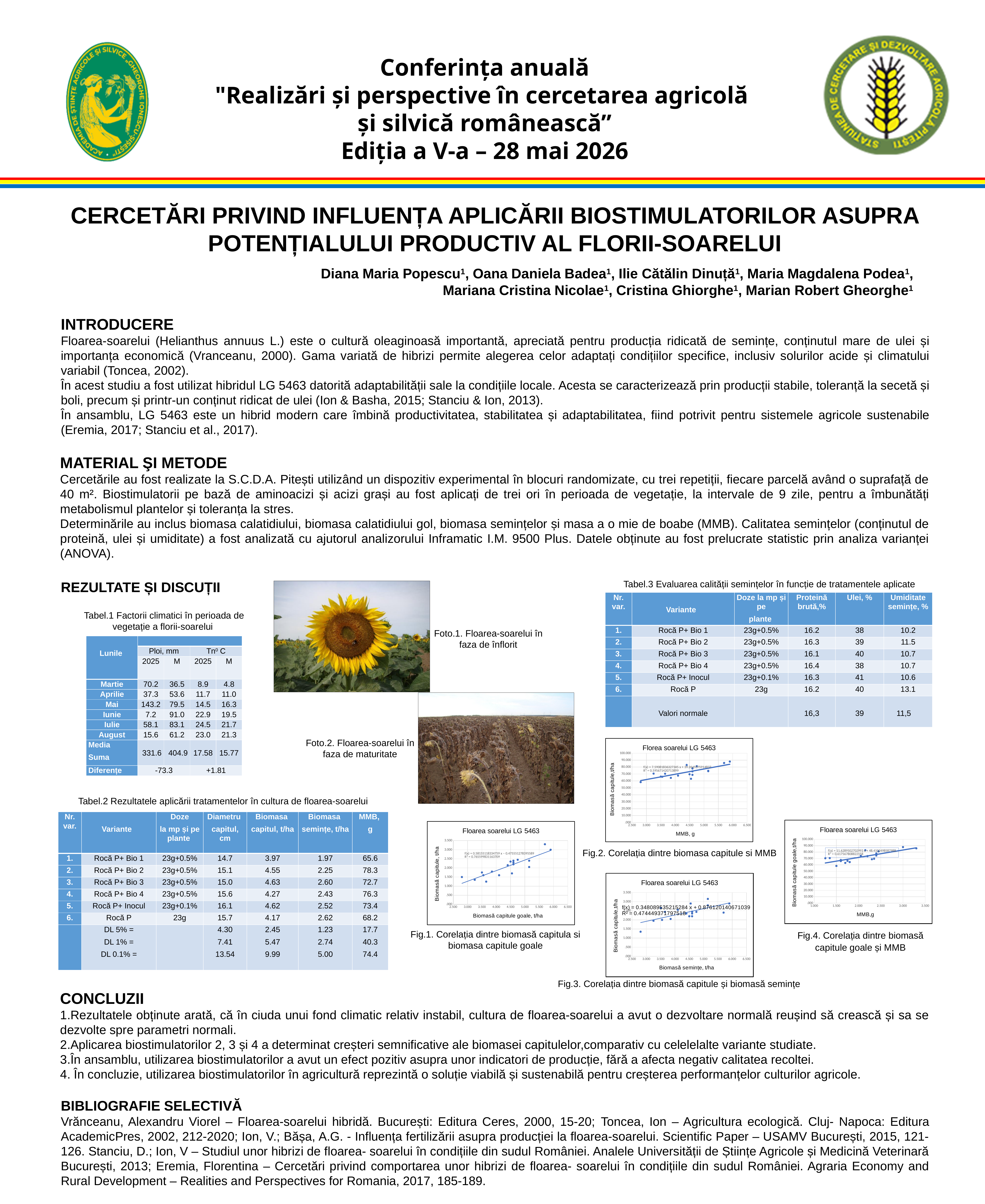
In Fig.1, do the plotted values of biomasă capitule rise or fall as biomasă capitule goale increases along the x axis? rise What kind of chart is Fig.4 (Corelația dintre biomasă capitule goale și MMB)? scatter chart What is the slope of the trend line equation printed on the chart in Fig.3? 0.348089535215284 What R² value is printed on the chart in Fig.3 (Corelația dintre biomasă capitule și biomasă semințe)? 0.474449371797518 In Fig.3 (Corelația dintre biomasă capitule și biomasă semințe), do the values rise or fall along the x axis? rise In Fig.4, do the values of biomasă capitule goale rise or fall as MMB increases? rise What kind of chart is Fig.1 (Corelația dintre biomasă capitula si biomasa capitule goale)? scatter chart What is the x-axis label of the chart in Fig.2? MMB, g What is the y-axis label of the chart in Fig.4? Biomasă capitule goale, t/ha